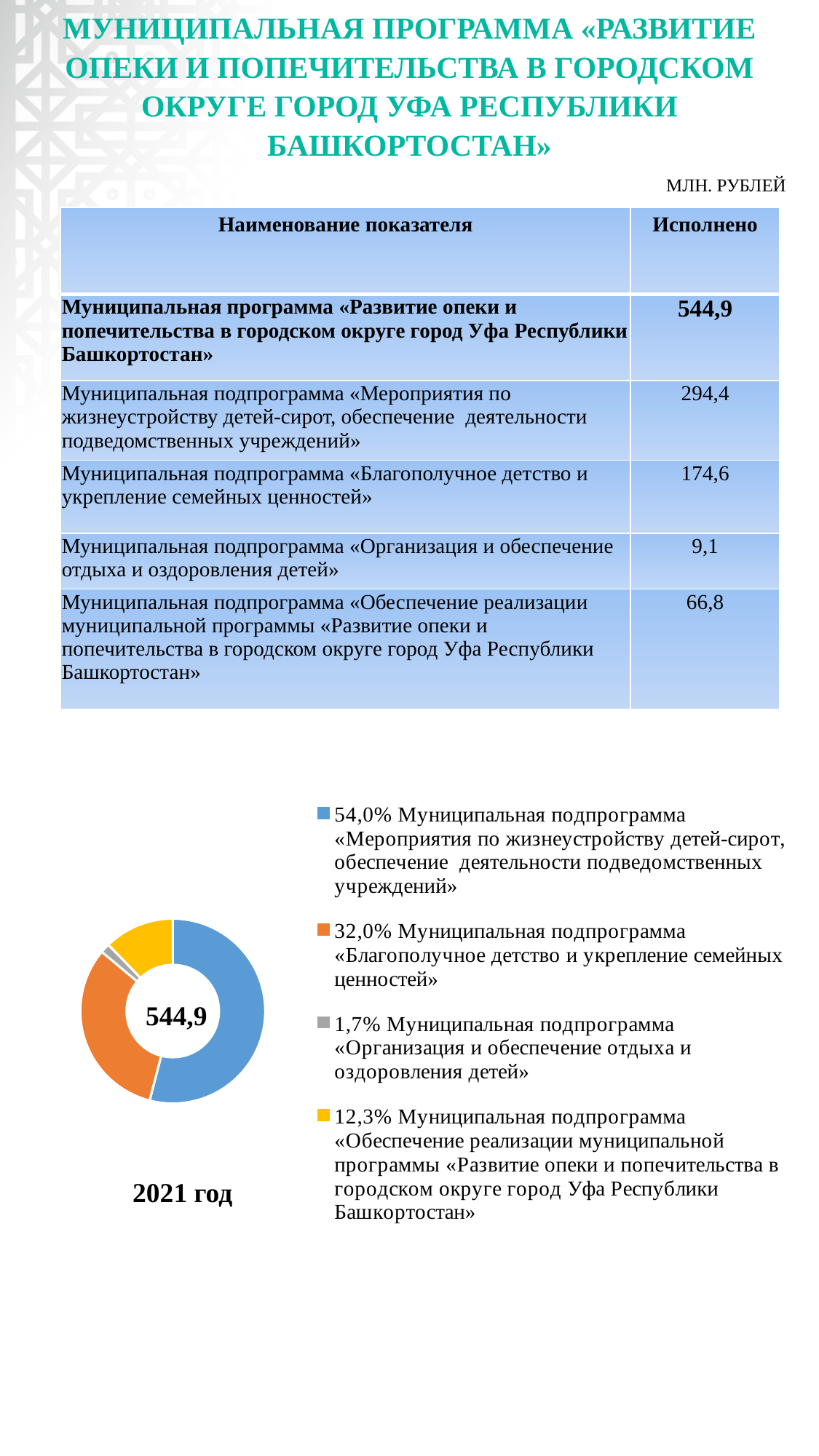
Which subprogram has the largest slice in the doughnut chart? Муниципальная подпрограмма «Мероприятия по жизнеустройству детей-сирот, обеспечение деятельности подведомственных учреждений» What is the difference in percentage points between the 54,0% slice and the 32,0% slice in the doughnut chart? 22,0% What share of the doughnut chart does the subprogram «Обеспечение реализации муниципальной программы «Развитие опеки и попечительства в городском округе город Уфа Республики Башкортостан»» take? 12,3% How many slices does the doughnut chart have? 4 What share of the doughnut chart does the subprogram «Мероприятия по жизнеустройству детей-сирот, обеспечение деятельности подведомственных учреждений» take? 54,0% What kind of chart is shown at the bottom of the slide? Doughnut (pie) chart What share of the doughnut chart does the subprogram «Благополучное детство и укрепление семейных ценностей» take? 32,0% What value is printed in the centre of the doughnut chart? 544,9 How many entries does the legend of the doughnut chart list? 4 In the doughnut chart, which slice is larger: «Благополучное детство и укрепление семейных ценностей» or «Обеспечение реализации муниципальной программы»? «Благополучное детство и укрепление семейных ценностей» Which subprogram has the smallest slice in the doughnut chart? Муниципальная подпрограмма «Организация и обеспечение отдыха и оздоровления детей»